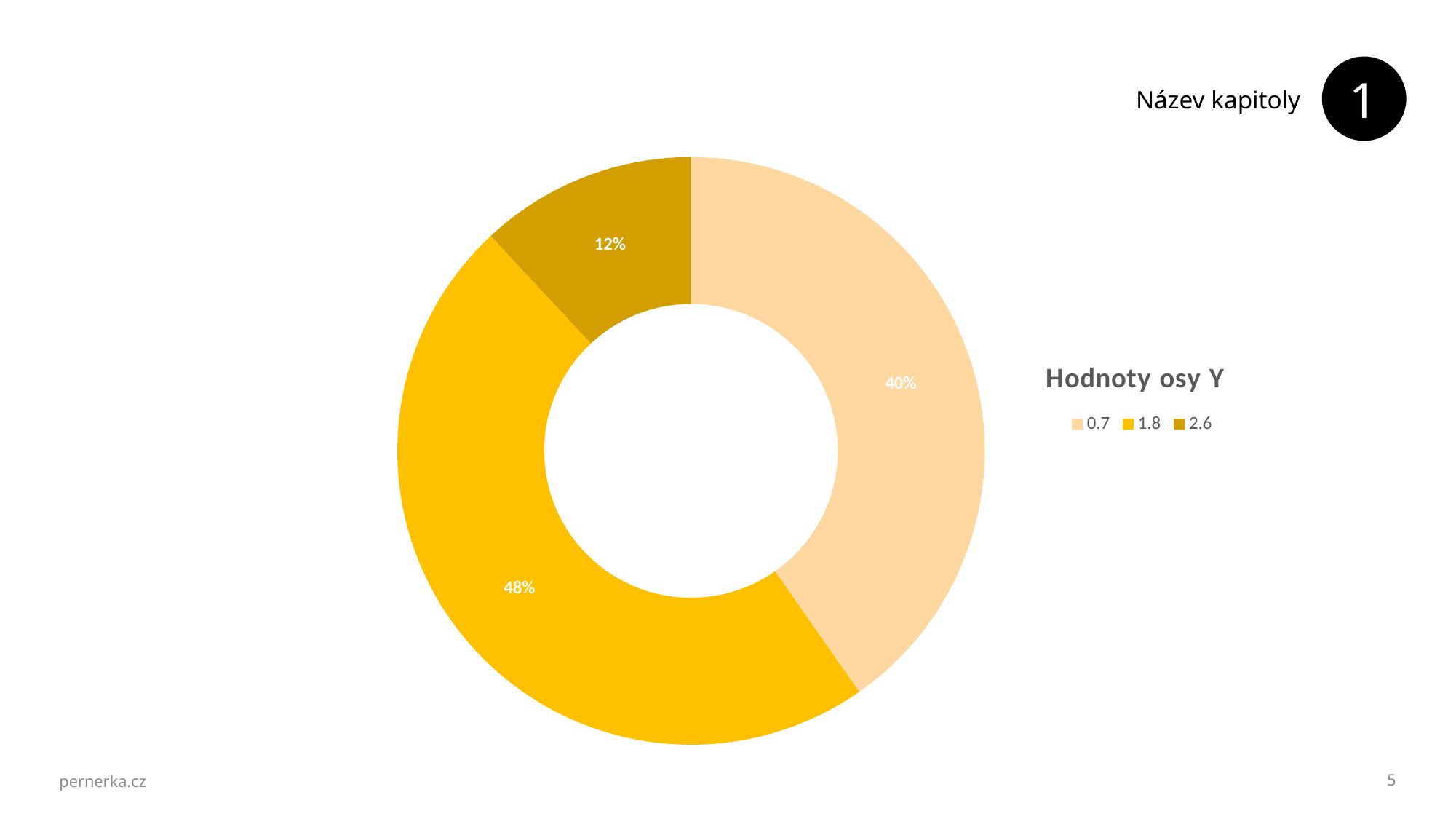
Which legend category has the largest share of the doughnut? 1.8 What is the title of the chart? Hodnoty osy Y Which slice is larger, the one for 0.7 or the one for 2.6? 0.7 What percentage is shown for the slice labelled 0.7 in the legend? 40% What is the difference in percentage points between the 1.8 slice and the 0.7 slice? 8 How many entries does the legend list? 3 What kind of chart is shown on the slide? doughnut chart What percentage is shown for the slice labelled 1.8 in the legend? 48% How many slices does the doughnut chart have? 3 Which legend category has the smallest share of the doughnut? 2.6 What is the share of the darkest gold slice? 12% What percentage is shown for the slice labelled 2.6 in the legend? 12%